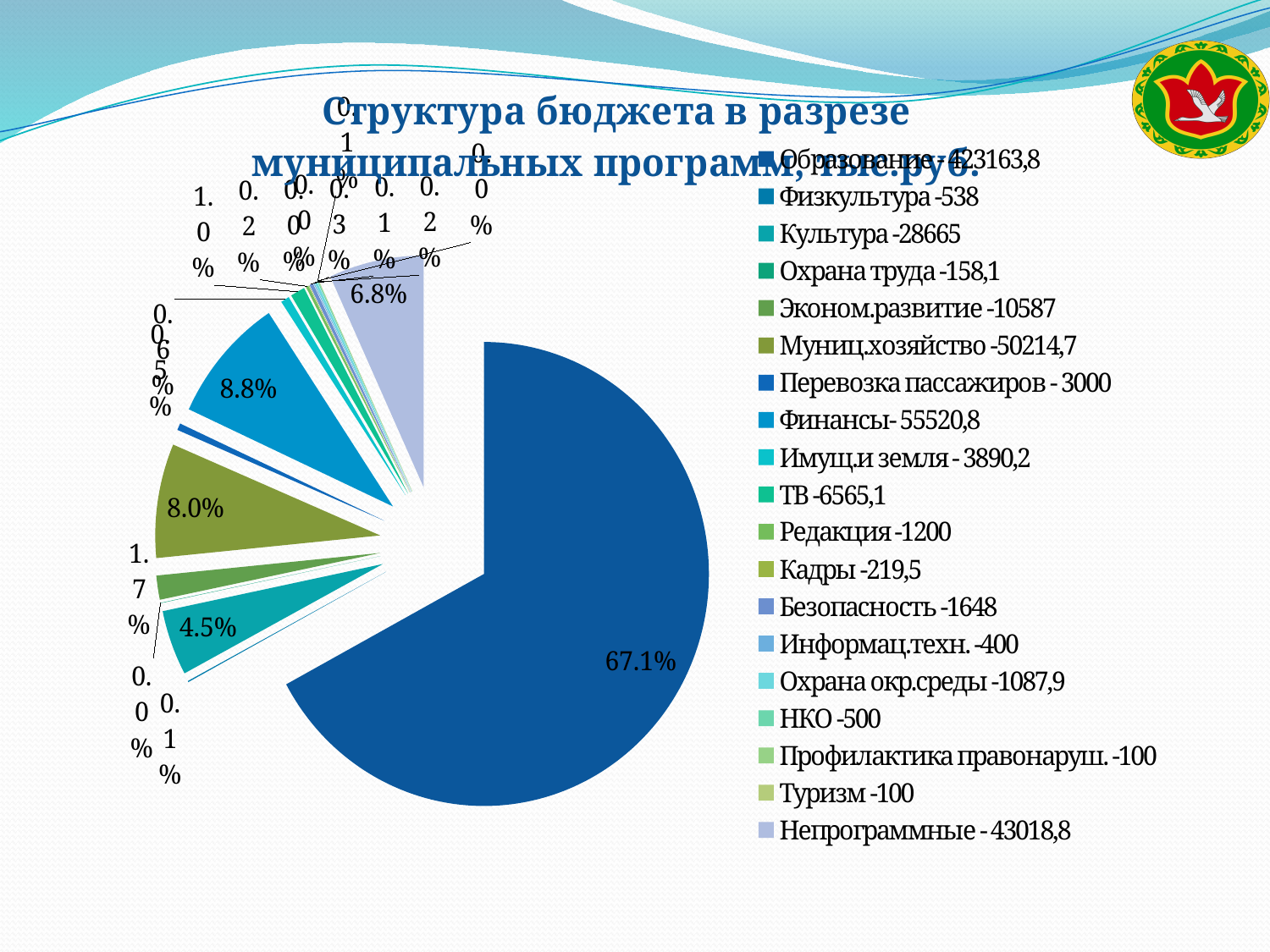
What share of the pie does Непрограммные have? 6.8% What kind of chart is shown on the slide? pie chart What share of the pie does Образование have? 67.1% Which slice is larger, Финансы or Муниц.хозяйство? Финансы Which category has the largest share of the pie chart? Образование What value is shown for Кадры in the legend? 219,5 What share of the pie does Финансы have? 8.8% What is the difference in percentage points between the Образование slice and the Финансы slice? 58.3 How many categories does the legend of the pie chart list? 19 What value is shown for Физкультура in the legend? 538